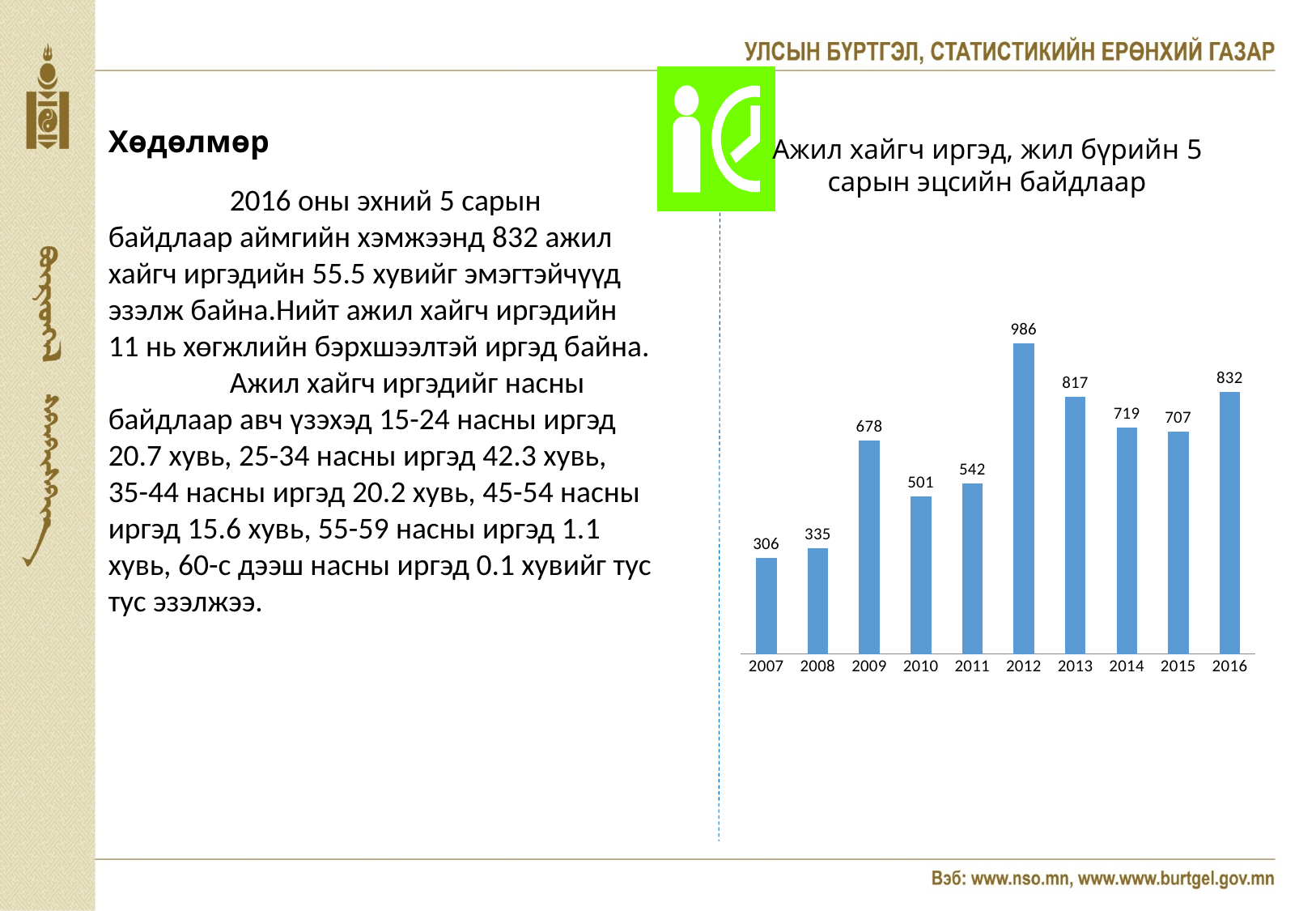
What is the value for 2016? 832 Do the values rise or fall from 2007 to 2012? rise Which is larger, the value for 2010 or the value for 2011? 2011 Which year has the highest value? 2012 What is the difference between the values for 2008 and 2007? 29 Which year has the lowest value? 2007 What is the value for 2012? 986 Which is larger, the value for 2013 or the value for 2014? 2013 What is the value for 2007? 306 What kind of chart is shown on the slide? bar chart How many years are shown on the x axis? 10 What is the difference between the values for 2012 and 2016? 154